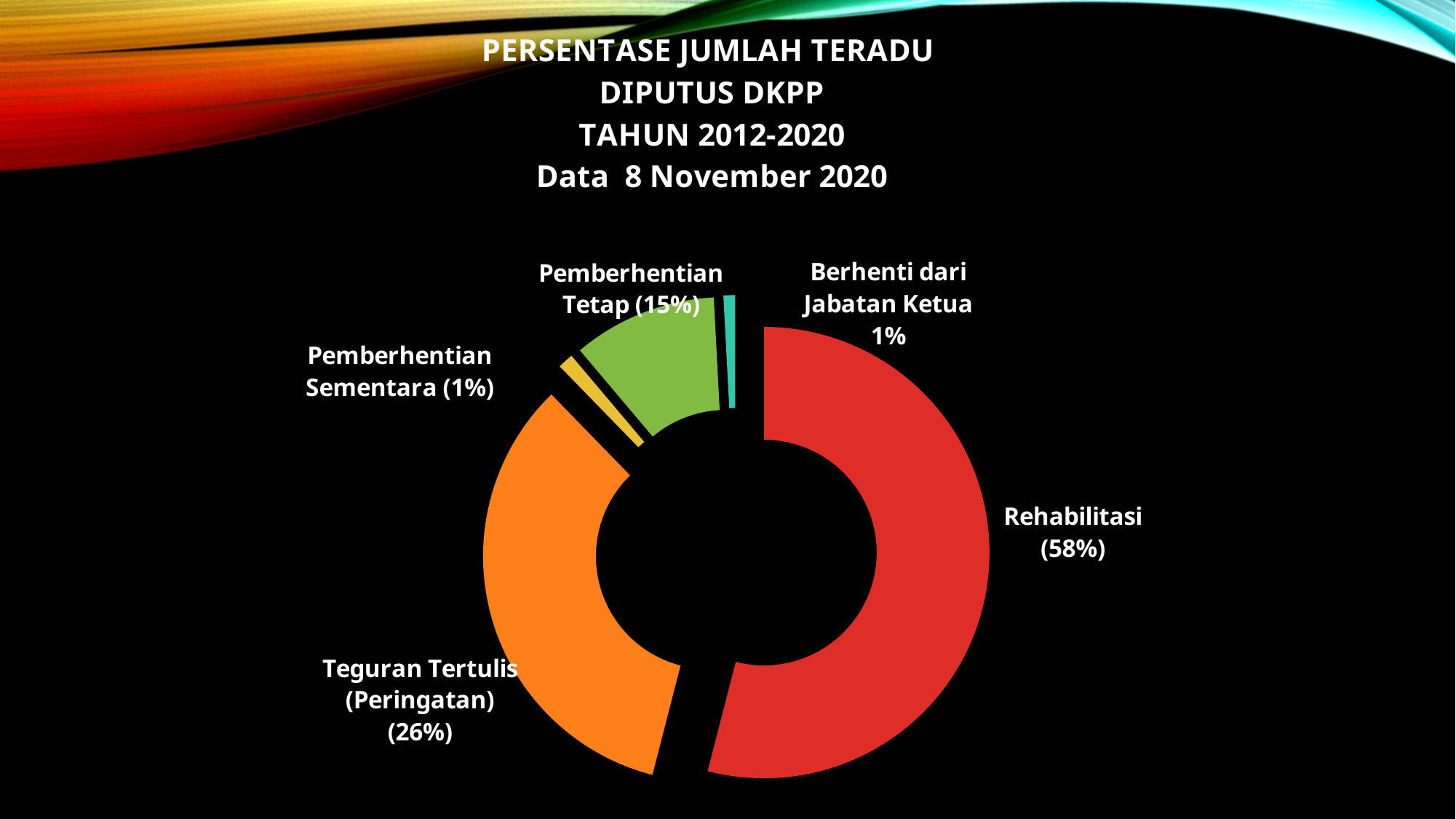
How many categories are shown in the chart? 5 What percentage is shown for Teguran Tertulis (Peringatan)? 26% Which category has the largest share of the chart? Rehabilitasi What percentage is shown for Berhenti dari Jabatan Ketua? 1% What kind of chart is shown on the slide? Doughnut chart What colour is the Rehabilitasi segment? Red What percentage is shown for Pemberhentian Sementara? 1% What percentage is shown for Pemberhentian Tetap? 15% What is the difference in percentage points between Rehabilitasi and Teguran Tertulis (Peringatan)? 32 What is the combined share of Rehabilitasi and Teguran Tertulis (Peringatan)? 84% What percentage of the chart is Rehabilitasi? 58% Which is larger, Teguran Tertulis (Peringatan) or Pemberhentian Tetap? Teguran Tertulis (Peringatan)